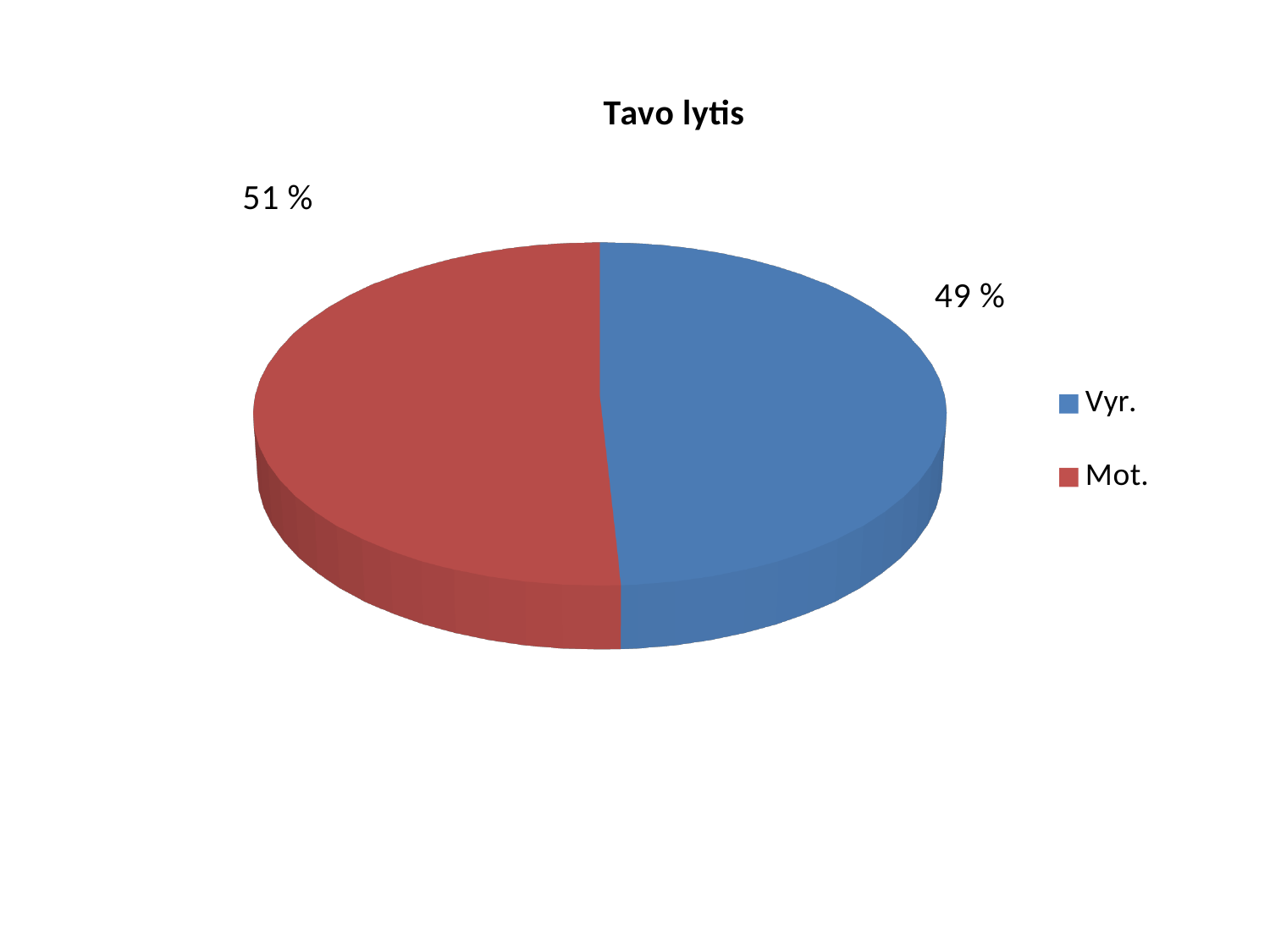
What is the difference in percentage points between the Mot. and Vyr. shares? 2 % What share of the pie does Mot. have? 51 % What share of the pie does Vyr. have? 49 % Which category has the largest share of the pie? Mot. What kind of chart is shown on the slide? pie chart What colour is the Vyr. slice? blue Which category has the smallest share of the pie? Vyr. How many categories does the pie chart have? 2 What is the title of the chart? Tavo lytis Which is larger, the share for Vyr. or the share for Mot.? Mot. How many entries does the legend list? 2